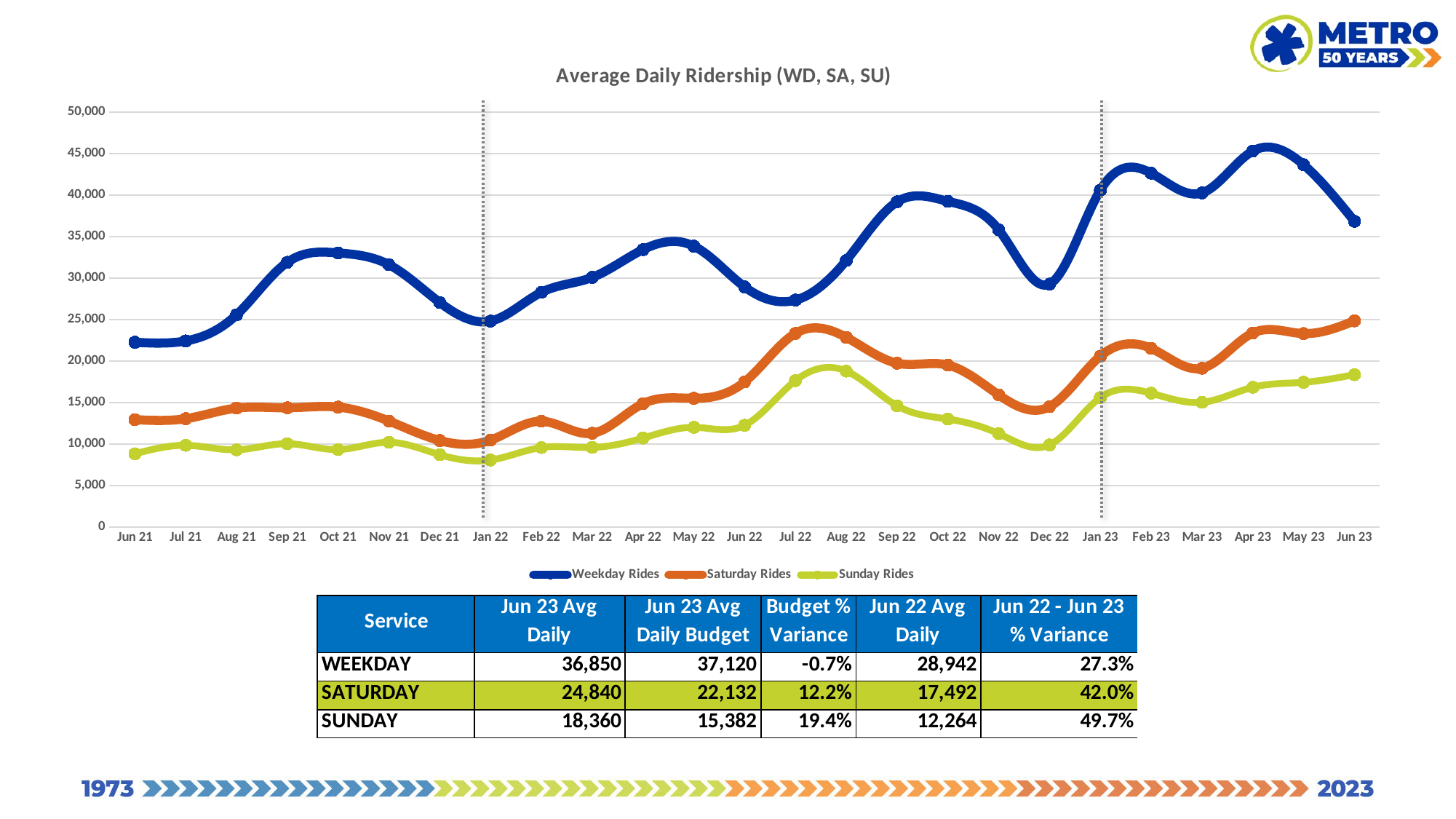
Is the value for Sunday Rides in Jan 22 greater or less than 10,000? less Is the value for Weekday Rides in Jun 21 greater or less than 25,000? less Which is larger: Weekday Rides in Sep 22 or Weekday Rides in Oct 21? Weekday Rides in Sep 22 Is the value for Saturday Rides in Jul 22 greater or less than 20,000? greater Which month has the highest value for Weekday Rides? Apr 23 How many months are plotted along the x axis of the chart? 25 How many series does the chart legend list? 3 What kind of chart is shown on the slide? line chart What is the difference between the Jun 23 average daily Weekday Rides and Saturday Rides, using the table values? 12,010 What is the Jun 23 average daily value for Saturday Rides, as shown in the table? 24,840 Do Weekday Rides rise or fall from Jun 21 to Oct 21? rise What is the title of the chart? Average Daily Ridership (WD, SA, SU)